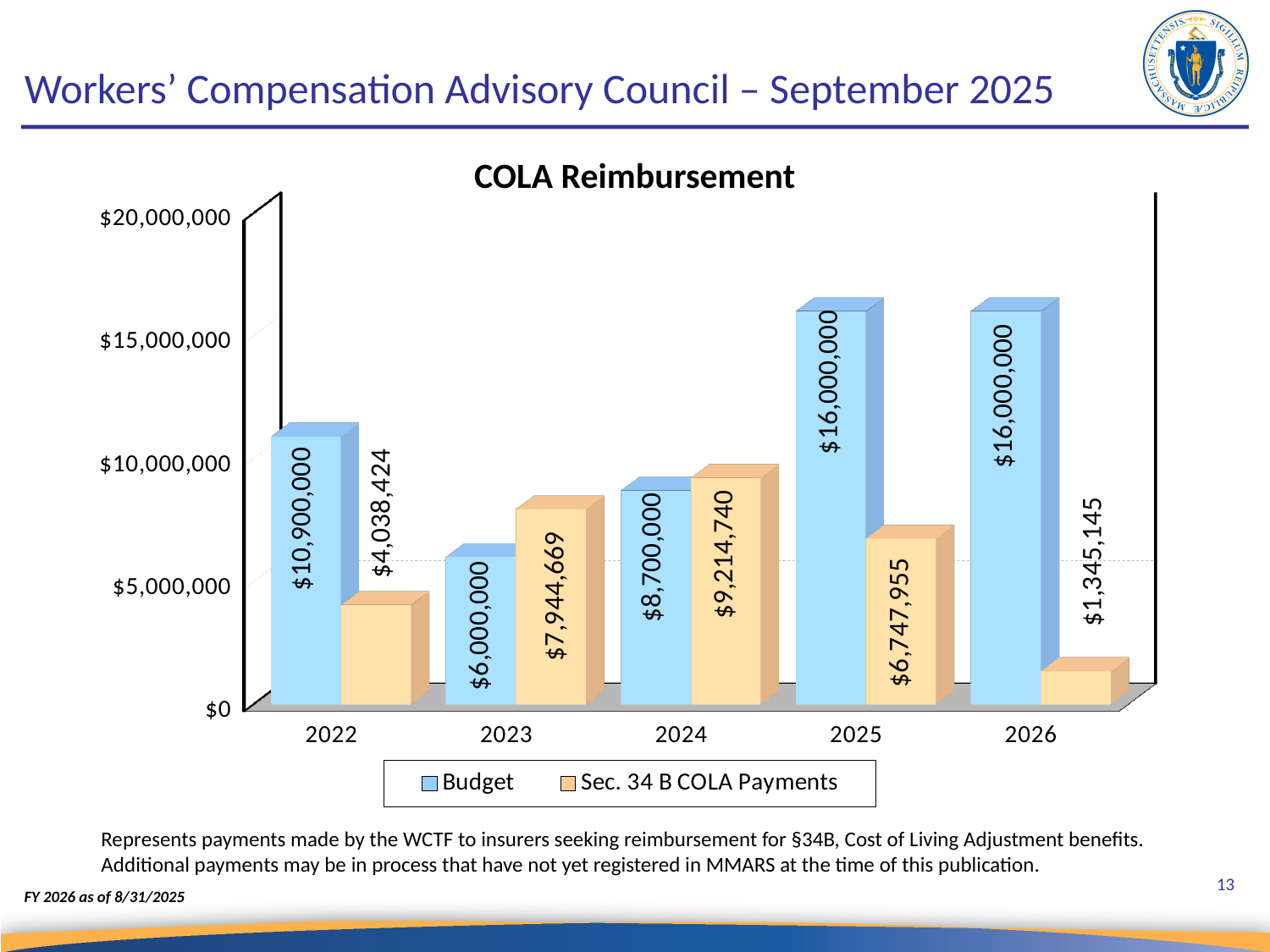
Which year has the highest Sec. 34 B COLA Payments value? 2024 What is the difference between the Budget and the Sec. 34 B COLA Payments in 2022? $6,861,576 What is the Sec. 34 B COLA Payments value for 2024? $9,214,740 How many years are shown on the x axis of the COLA Reimbursement chart? 5 What is the Budget value for 2022 in the COLA Reimbursement chart? $10,900,000 In 2023, which is larger: the Budget or the Sec. 34 B COLA Payments? Sec. 34 B COLA Payments Which year has the lowest Sec. 34 B COLA Payments value? 2026 Which year has the lowest Budget value? 2023 What is the Sec. 34 B COLA Payments value for 2026? $1,345,145 What is the difference between the Sec. 34 B COLA Payments and the Budget in 2024? $514,740 How many series does the legend of the COLA Reimbursement chart list? 2 What type of chart is the COLA Reimbursement chart? Bar chart